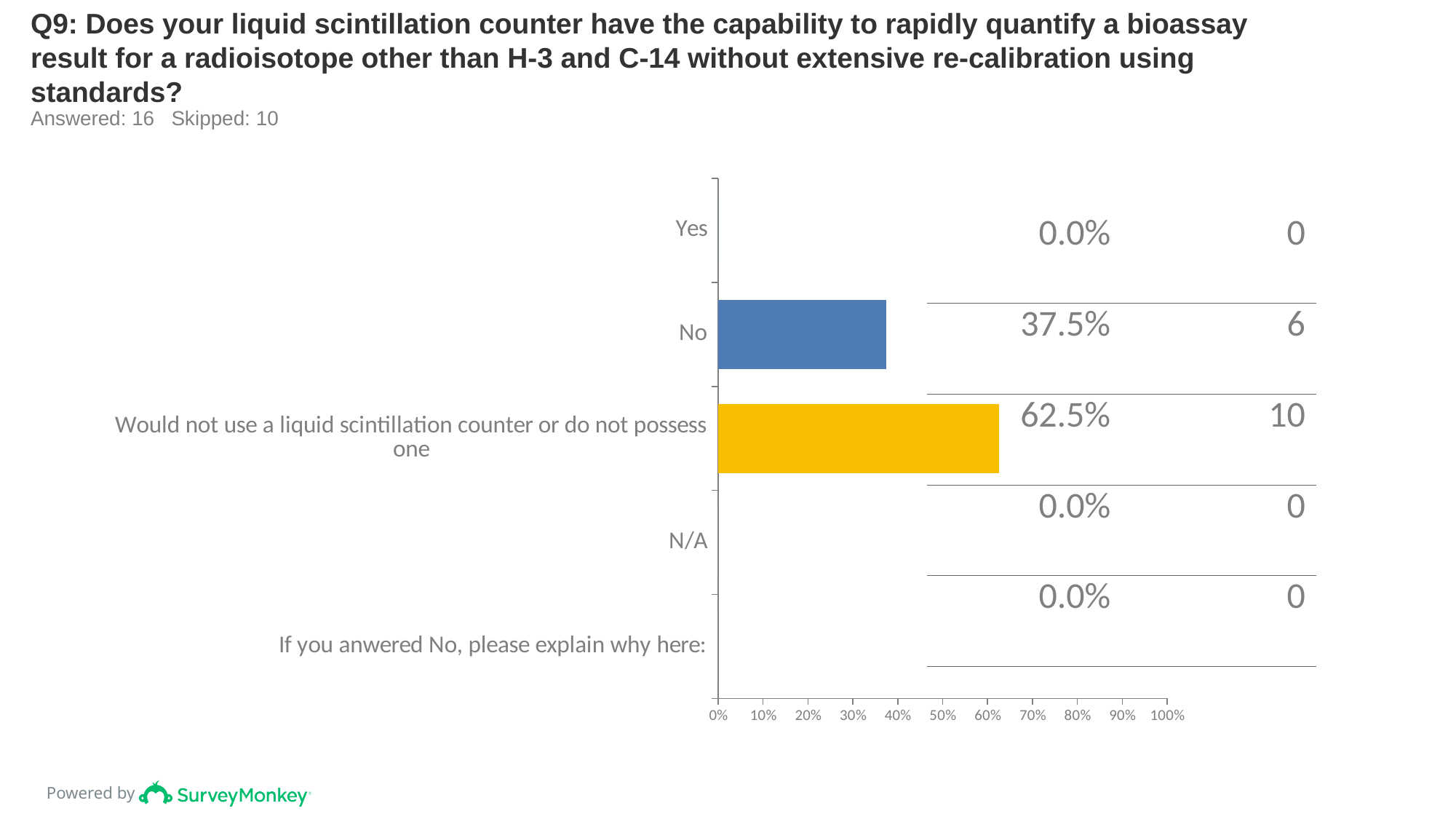
Which answer option has the highest percentage? Would not use a liquid scintillation counter or do not possess one How many respondents answered this question in total? 16 How many answer options are shown on the chart? 5 What percentage of respondents chose "Would not use a liquid scintillation counter or do not possess one"? 62.5% What percentage of respondents answered "No"? 37.5% How many respondents answered "Yes"? 0 How many respondents chose "Would not use a liquid scintillation counter or do not possess one"? 10 What kind of chart is shown on the slide? bar chart Is the value for "No" greater or less than 40%? less What is the difference in percentage points between "Would not use a liquid scintillation counter or do not possess one" and "No"? 25.0% What colour is the bar for "No"? blue Which has a larger share of responses, "No" or "Would not use a liquid scintillation counter or do not possess one"? Would not use a liquid scintillation counter or do not possess one